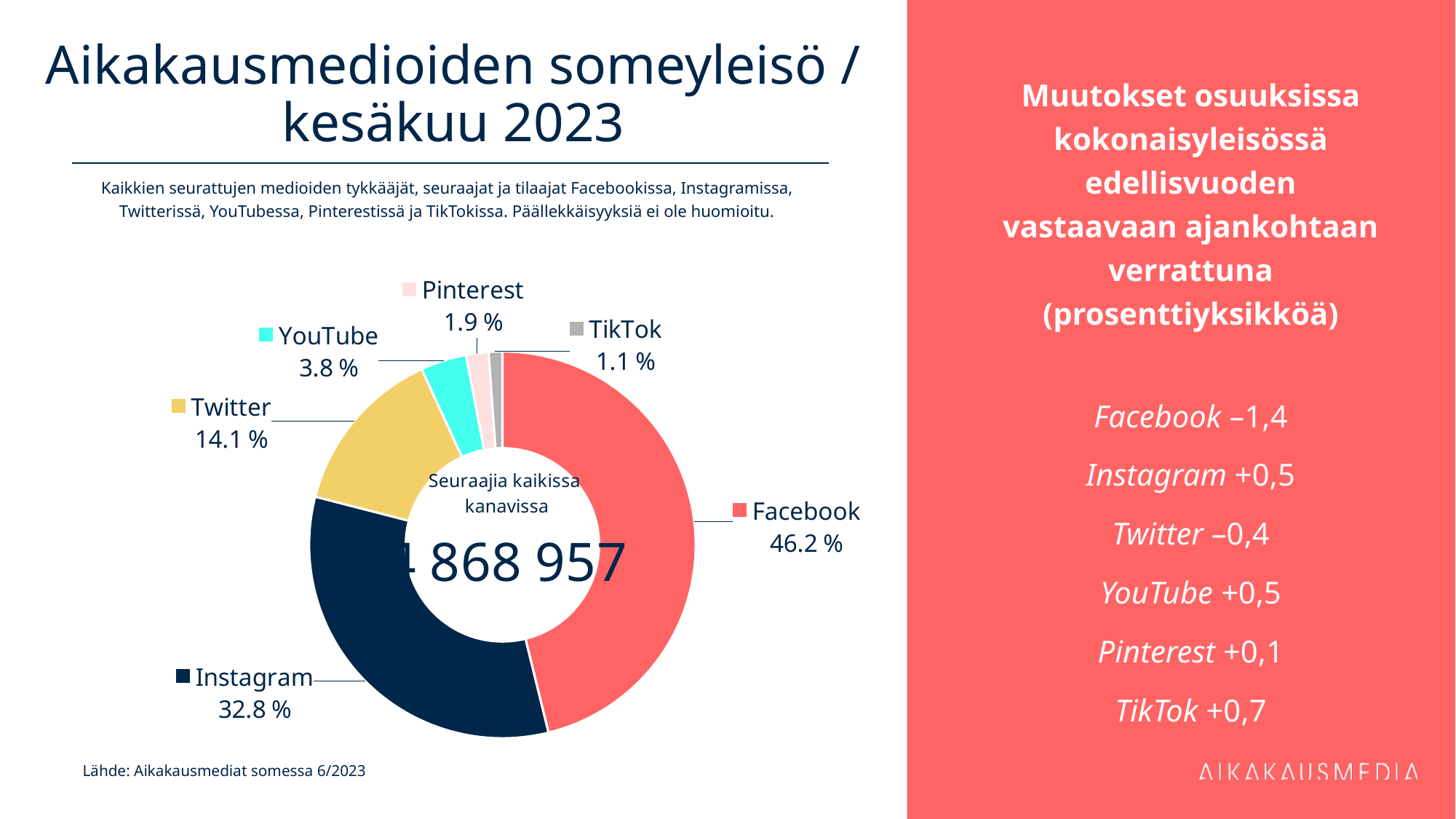
What share of the social media audience does Facebook hold in the donut chart? 46.2 % What is the combined share of Pinterest and TikTok? 3.0 % Which platform has the smallest slice in the donut chart? TikTok What share does TikTok hold in the donut chart? 1.1 % Which platform has the largest slice in the donut chart? Facebook What is the difference in percentage points between Facebook's and Instagram's shares? 13.4 What share does Twitter hold in the donut chart? 14.1 % What share does Instagram hold in the donut chart? 32.8 % How many platforms are shown as slices in the donut chart? 6 Which has a larger share, Twitter or YouTube? Twitter What type of chart is shown on the slide? Donut (pie) chart What share does YouTube hold in the donut chart? 3.8 %